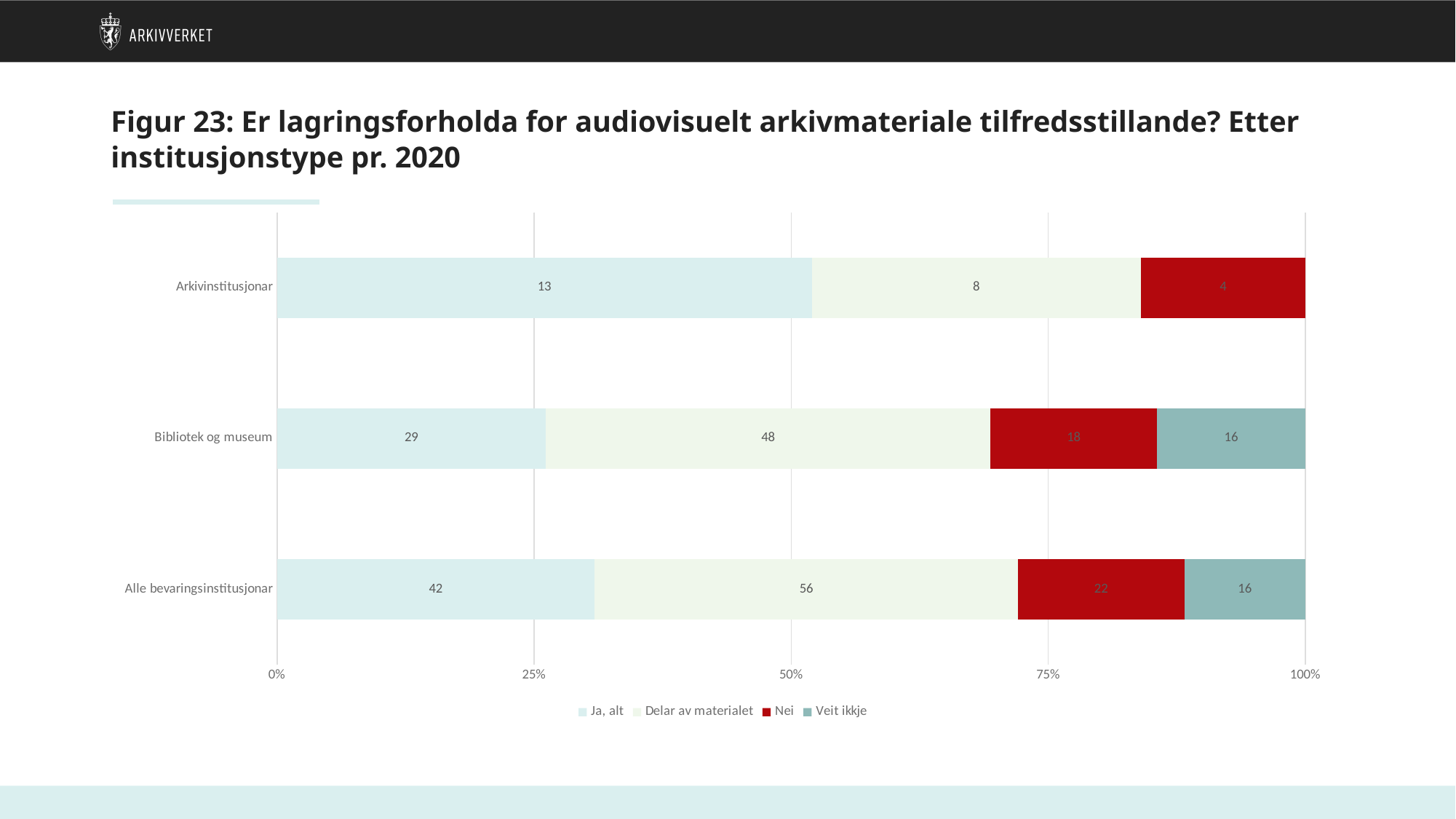
Which category has the lowest value for "Ja, alt"? Arkivinstitusjonar What is the value for "Nei" for Arkivinstitusjonar? 4 What is the value for "Ja, alt" for Bibliotek og museum? 29 Which is larger for Bibliotek og museum: "Ja, alt" or "Delar av materialet"? Delar av materialet What is the value for "Veit ikkje" for Bibliotek og museum? 16 What is the total of the data labels in the Bibliotek og museum bar? 111 What kind of chart is shown on the slide? Stacked bar chart How many series does the legend list? 4 How many categories are shown on the vertical axis? 3 Which category has the highest value for "Nei"? Alle bevaringsinstitusjonar What is the difference between the "Delar av materialet" values for Alle bevaringsinstitusjonar and Bibliotek og museum? 8 What is the value for "Delar av materialet" for Alle bevaringsinstitusjonar? 56